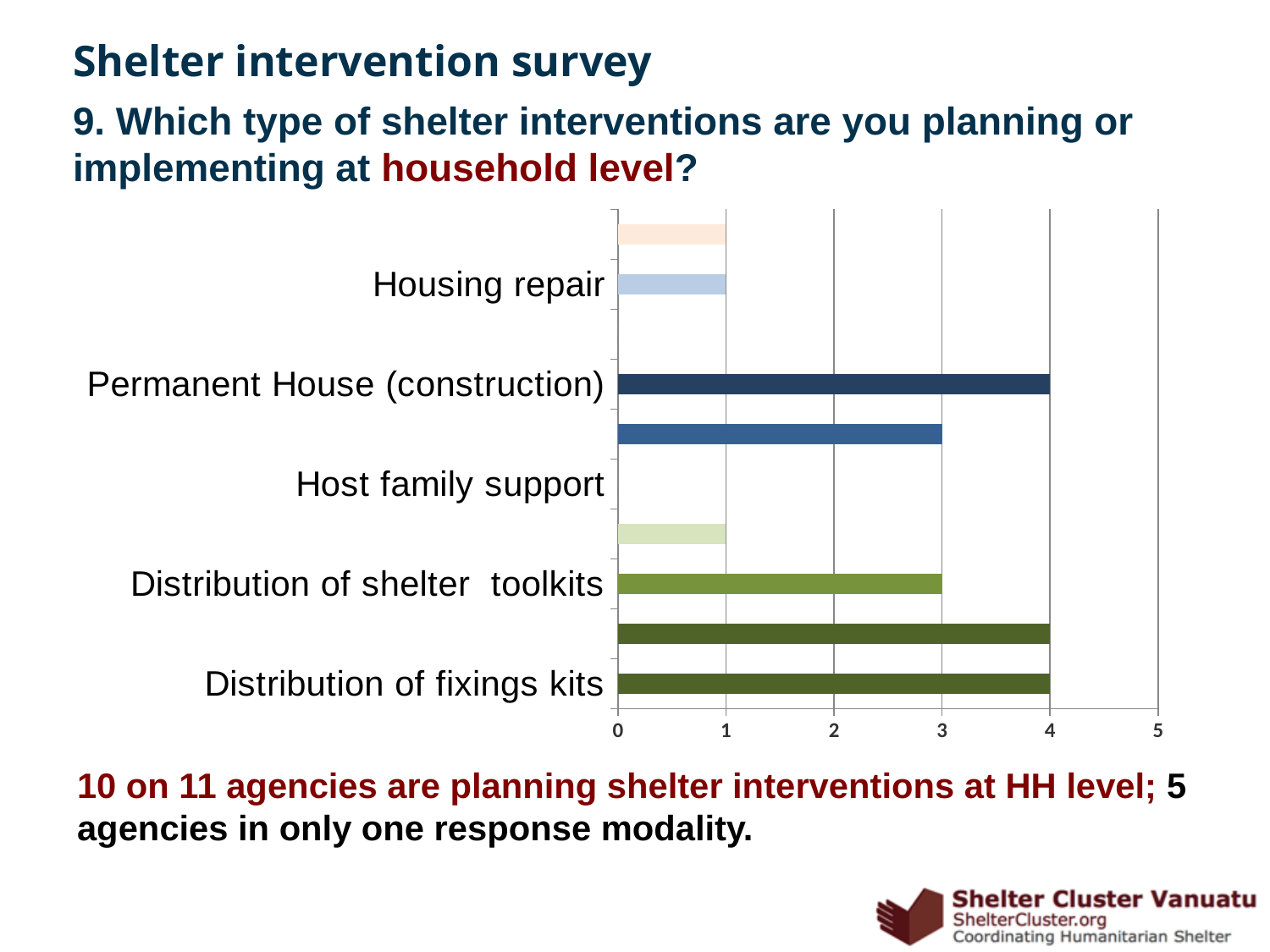
What is the value for Permanent House (construction)? 4 What is the highest value shown on the horizontal axis of the chart? 5 How many category labels are shown on the vertical axis of the chart? 5 What kind of chart is shown on the slide? bar chart What is the difference between the value for Distribution of fixings kits and the value for Distribution of shelter toolkits? 1 Which is larger, the value for Permanent House (construction) or the value for Distribution of shelter toolkits? Permanent House (construction) Is the value for Housing repair greater or less than 2? less What is the value for Housing repair? 1 Is the value for Permanent House (construction) greater or less than 3? greater What is the value for Distribution of fixings kits? 4 What is the value for Distribution of shelter toolkits? 3